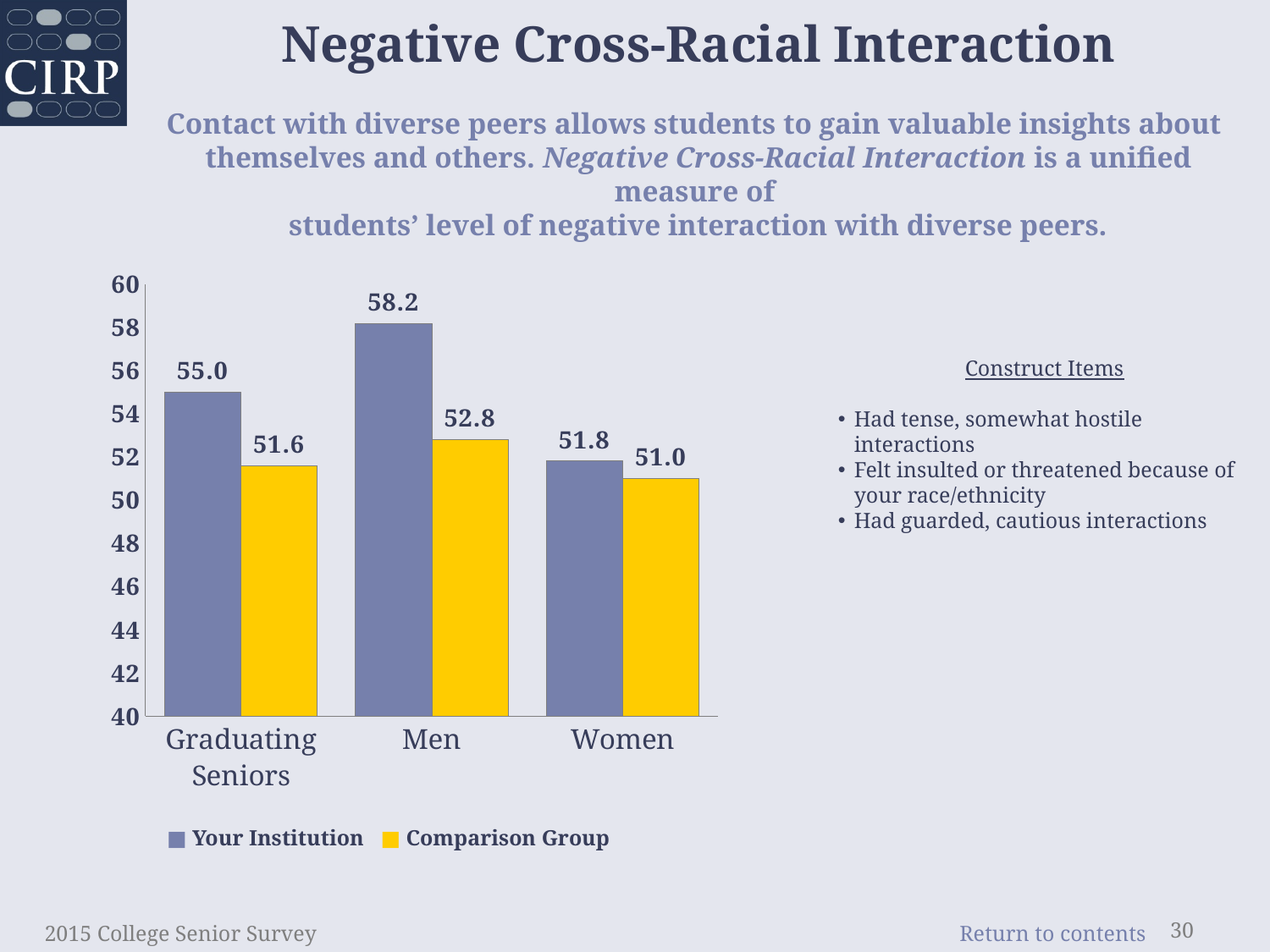
Which category has the lowest Comparison Group value? Women What is the difference between the Your Institution and Comparison Group values for Men? 5.4 How many series does the legend list? 2 What is the Your Institution value for Men? 58.2 Which category has the highest Your Institution value? Men What is the difference between the Your Institution values for Graduating Seniors and Women? 3.2 How many categories are shown on the x axis? 3 What kind of chart is shown on the slide? Bar chart What is the Comparison Group value for Women? 51.0 What is the Comparison Group value for Graduating Seniors? 51.6 Which is larger for Graduating Seniors: Your Institution or Comparison Group? Your Institution Is the Your Institution value for Women greater or less than 50? greater